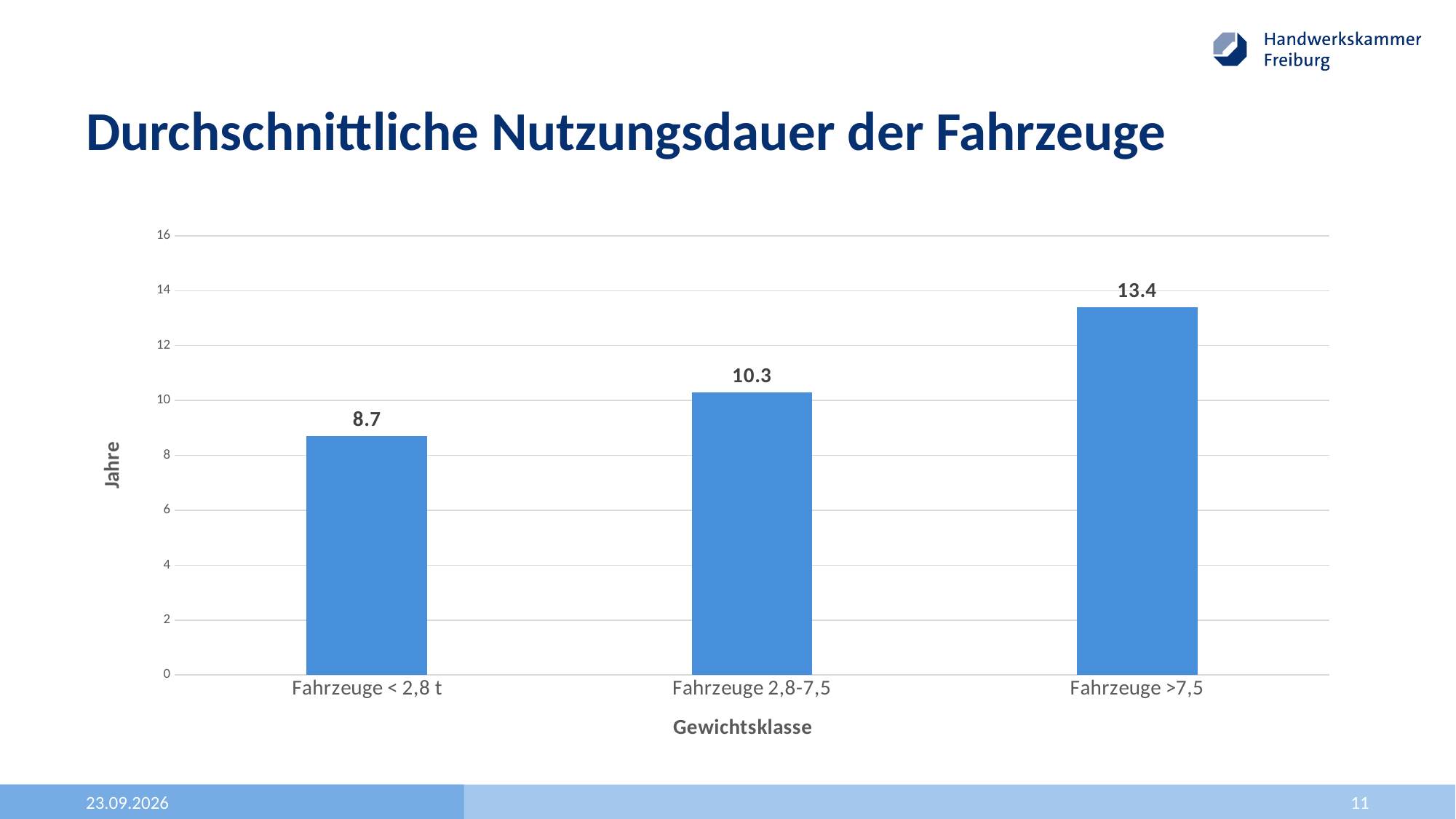
Which weight class has the lowest average useful life? Fahrzeuge < 2,8 t What is the difference in years between Fahrzeuge >7,5 and Fahrzeuge < 2,8 t? 4.7 What is the label of the vertical axis? Jahre How many weight classes are shown in the chart? 3 What value is shown for Fahrzeuge 2,8-7,5? 10.3 Which weight class has the highest average useful life? Fahrzeuge >7,5 What is the average useful life in years for Fahrzeuge < 2,8 t? 8.7 What kind of chart is shown on the slide? Bar chart Is the value for Fahrzeuge 2,8-7,5 greater or less than 10? greater Which is larger, the value for Fahrzeuge 2,8-7,5 or for Fahrzeuge >7,5? Fahrzeuge >7,5 What value is shown for Fahrzeuge >7,5? 13.4 What is the difference between Fahrzeuge 2,8-7,5 and Fahrzeuge < 2,8 t? 1.6